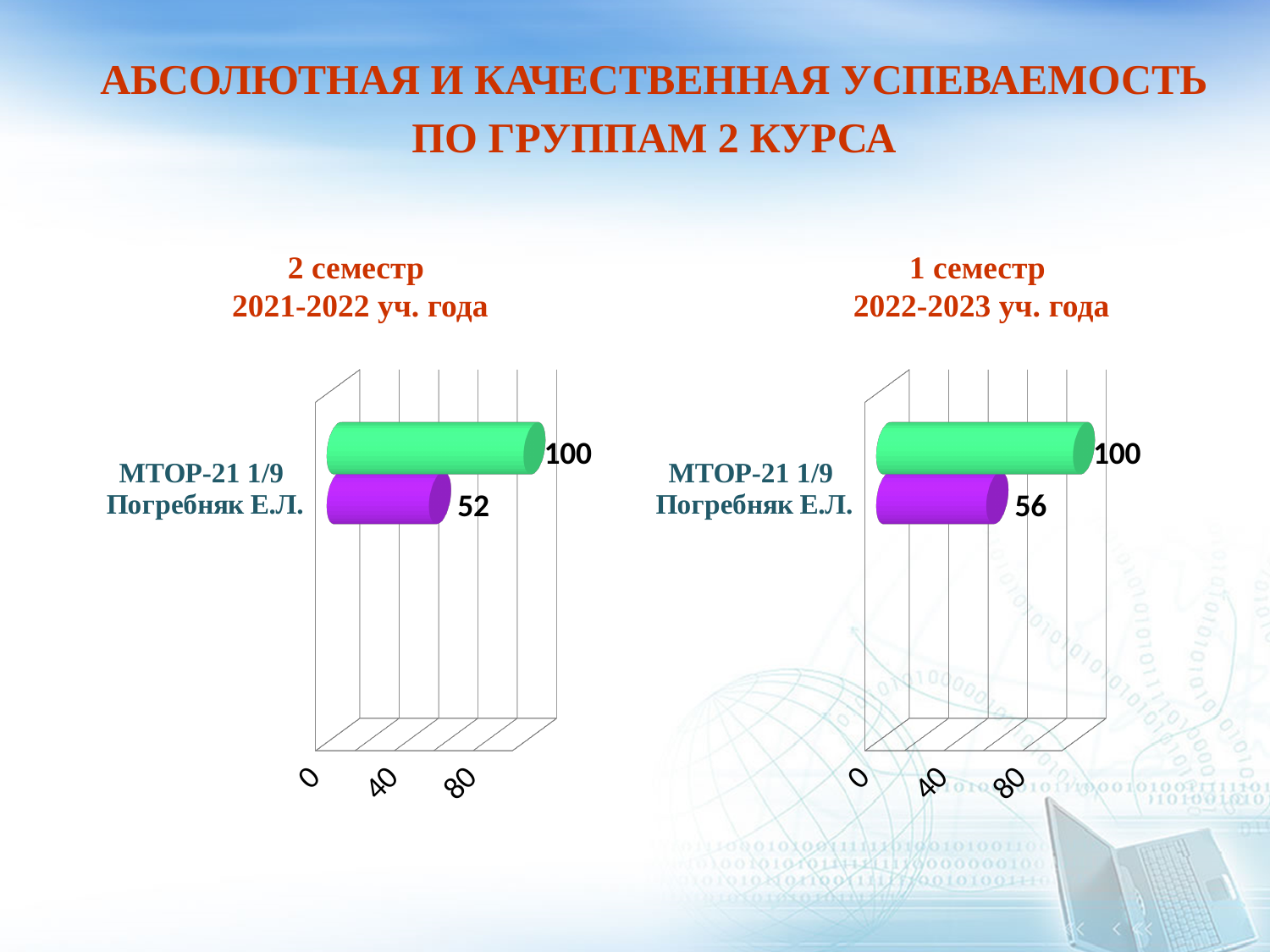
What is the category label shown next to the left chart (2 семестр 2021-2022 уч. года)? МТОР-21 1/9 Погребняк Е.Л. In the right chart (1 семестр 2022-2023 уч. года), is the purple bar value greater or less than 80? less What type of chart is used on the left side of the slide (2 семестр 2021-2022 уч. года)? bar chart In the right chart (1 семестр 2022-2023 уч. года), what is the difference between the green bar value and the purple bar value? 44 In the left chart (2 семестр 2021-2022 уч. года), is the purple bar value greater or less than 40? greater Which is larger: the purple bar value in the left chart (2 семестр 2021-2022) or the purple bar value in the right chart (1 семестр 2022-2023)? the right chart (56) In the left chart (2 семестр 2021-2022 уч. года), what value is shown on the green bar for МТОР-21 1/9? 100 In the left chart (2 семестр 2021-2022 уч. года), what is the difference between the green bar value and the purple bar value? 48 How many categories (groups) are shown in the right chart (1 семестр 2022-2023 уч. года)? 1 In the left chart (2 семестр 2021-2022 уч. года), what value is shown on the purple bar for МТОР-21 1/9? 52 In the right chart (1 семестр 2022-2023 уч. года), what value is shown on the green bar for МТОР-21 1/9? 100 In the right chart (1 семестр 2022-2023 уч. года), what value is shown on the purple bar for МТОР-21 1/9? 56